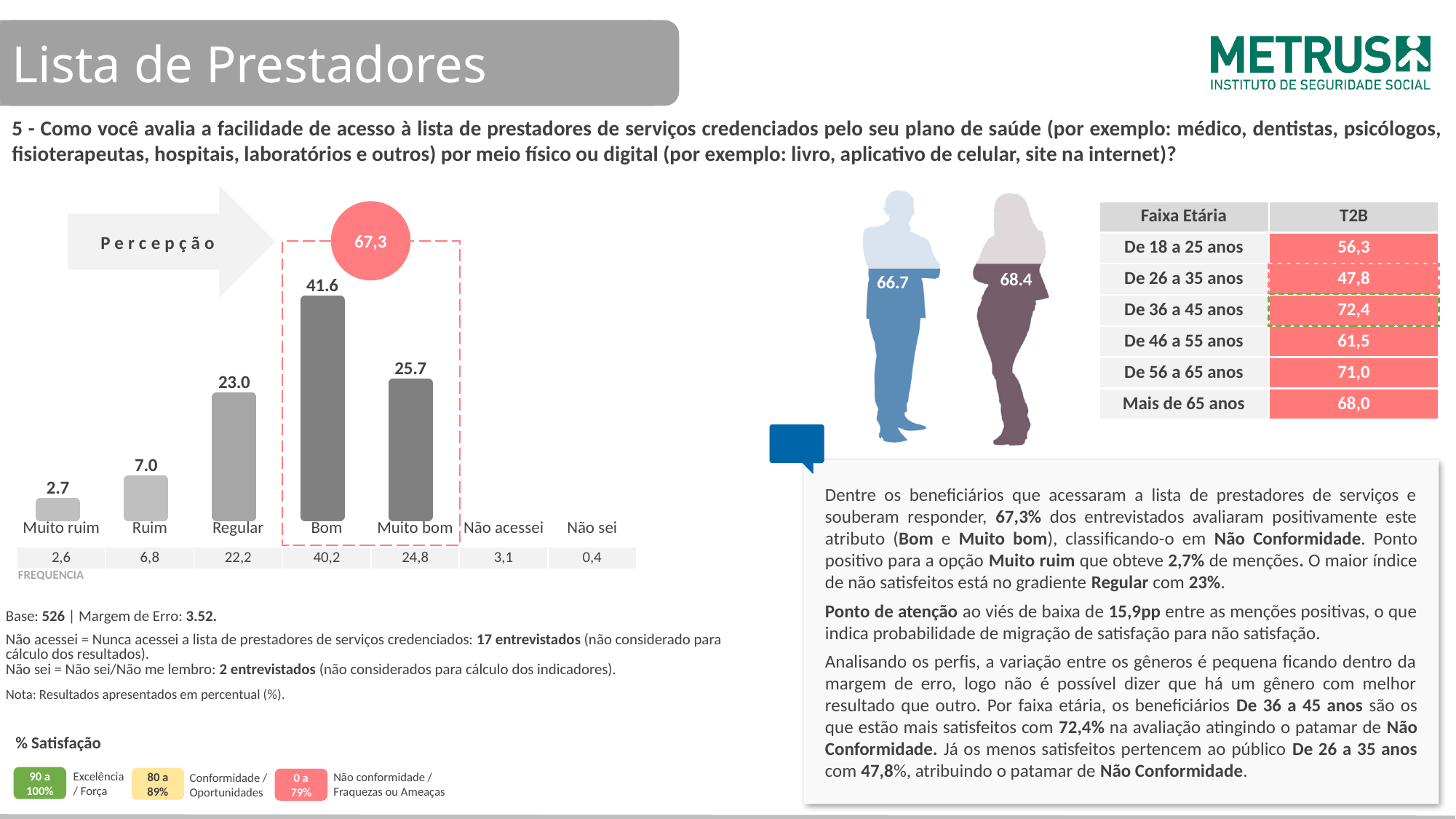
In the bar chart, what is the difference between the values for Bom and Muito bom? 15.9 In the bar chart, which category has the highest value? Bom In the bar chart, what is the value for Muito ruim? 2.7 In the bar chart, what is the value for Bom? 41.6 In the bar chart, how many bars are plotted? 5 In the FREQUENCIA row below the bar chart, what is the value for Não acessei? 3,1 In the Faixa Etária table, which age group has the highest T2B value? De 36 a 45 anos In the bar chart, which is larger, the value for Ruim or the value for Regular? Regular What kind of chart is shown on the left of the slide? bar chart In the bar chart, what is the value for Regular? 23.0 In the bar chart, which category has the lowest plotted value? Muito ruim In the Faixa Etária table, what is the T2B value for De 26 a 35 anos? 47,8